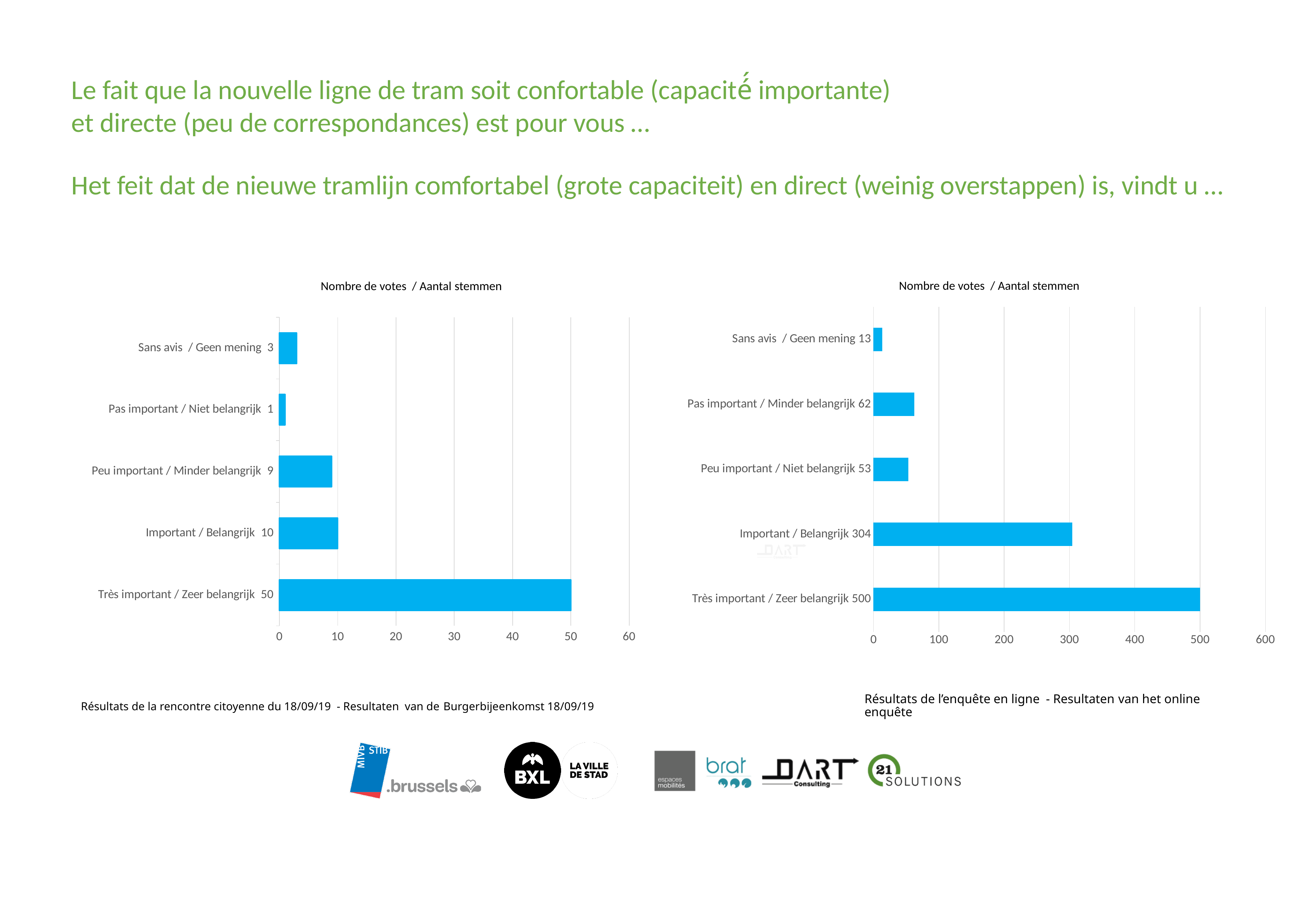
In the right chart (enquête en ligne), how many votes did 'Sans avis / Geen mening' receive? 13 In the right chart (enquête en ligne), is the value for 'Sans avis / Geen mening' greater or less than 100? less In the left chart (rencontre citoyenne), what is the difference in votes between 'Important / Belangrijk' and 'Peu important / Minder belangrijk'? 1 In the right chart (enquête en ligne), which category has the highest number of votes? Très important / Zeer belangrijk In the right chart (enquête en ligne), which has more votes: 'Pas important / Minder belangrijk' or 'Peu important / Niet belangrijk'? Pas important / Minder belangrijk What is the title of the left chart? Nombre de votes / Aantal stemmen In the right chart (enquête en ligne), what is the difference in votes between 'Très important / Zeer belangrijk' and 'Important / Belangrijk'? 196 In the right chart (enquête en ligne), how many votes did 'Important / Belangrijk' receive? 304 How many categories are shown in the left chart (rencontre citoyenne)? 5 In the left chart (rencontre citoyenne), which category has the lowest number of votes? Pas important / Niet belangrijk In the left chart (rencontre citoyenne), how many votes did 'Très important / Zeer belangrijk' receive? 50 What type of chart is the right chart (enquête en ligne)? bar chart